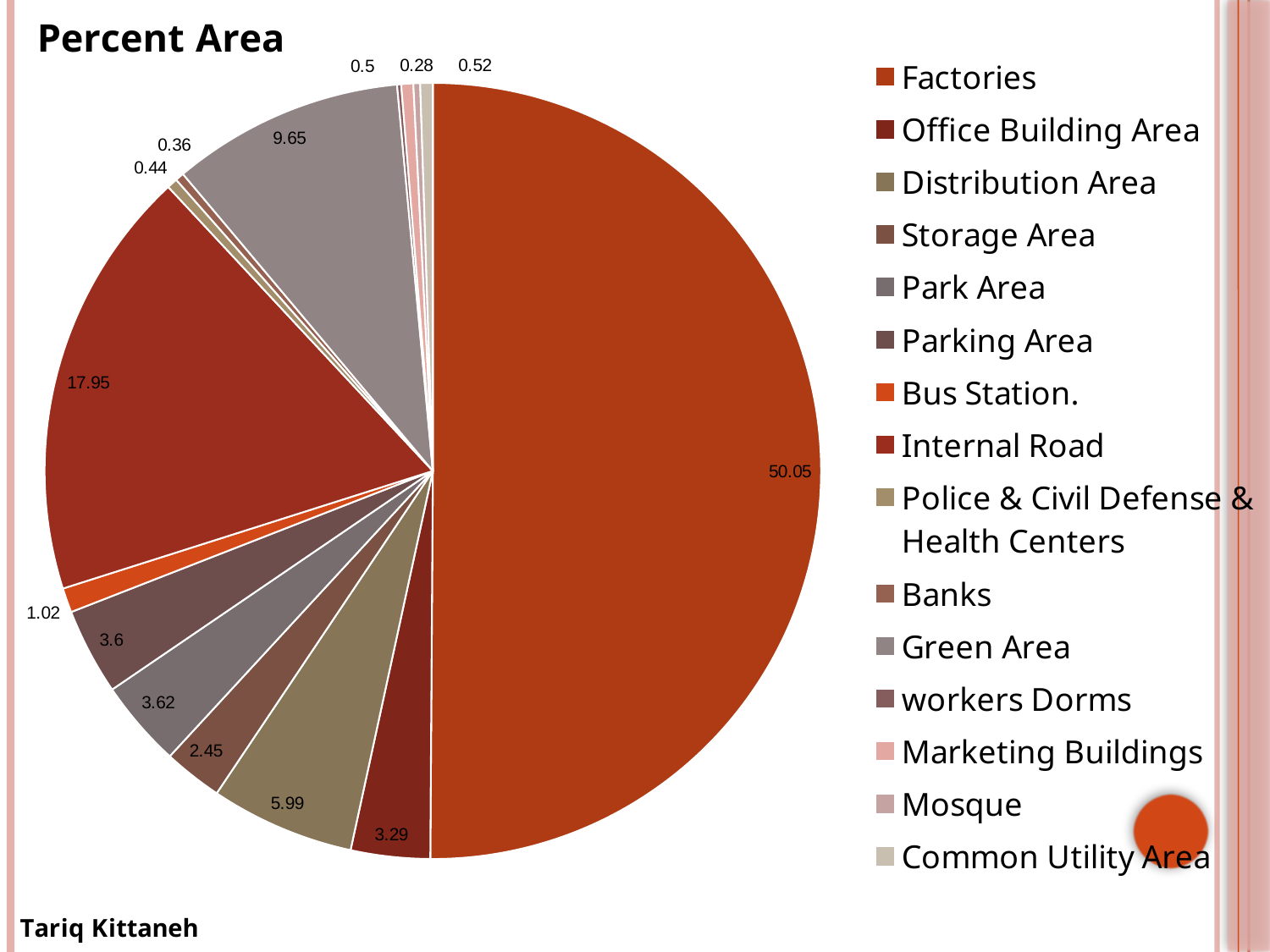
What type of chart is shown on the slide? pie chart What is the value shown for Internal Road? 17.95 How many categories does the legend of the pie chart list? 15 What is the value shown for Factories? 50.05 What is the value shown for Green Area? 9.65 Which is larger, the value for Green Area or the value for Storage Area? Green Area Which is larger, the value for Distribution Area or the value for Office Building Area? Distribution Area What is the value shown for Bus Station? 1.02 What is the value shown for Distribution Area? 5.99 Which category has the largest slice of the pie? Factories What is the difference between the values for Factories and Internal Road? 32.1 What is the title of the chart? Percent Area